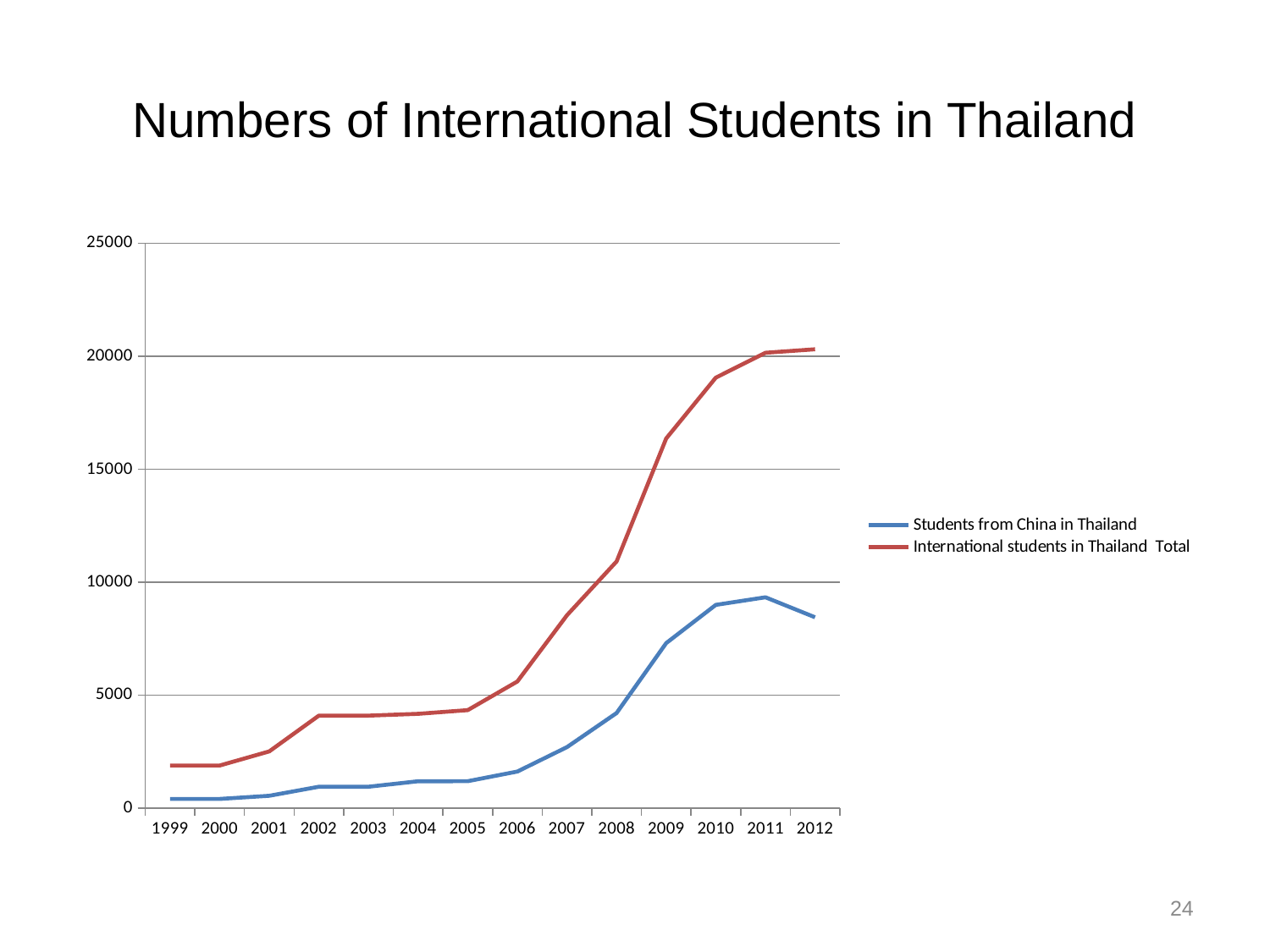
In which year does the Students from China in Thailand series reach its highest value? 2011 Is the value for Students from China in Thailand in 2008 greater or less than 5000? less How many years are plotted along the x axis? 14 What kind of chart is shown on the slide? Line chart Which series is drawn in red? International students in Thailand Total Is the value for International students in Thailand Total in 2010 greater or less than 20000? less What is the title of the chart? Numbers of International Students in Thailand Is the value for Students from China in Thailand in 2011 greater or less than 10000? less How many series does the legend list? 2 Does the International students in Thailand Total series generally rise or fall from 1999 to 2012? rise Which is larger for Students from China in Thailand: the value in 2011 or the value in 2012? 2011